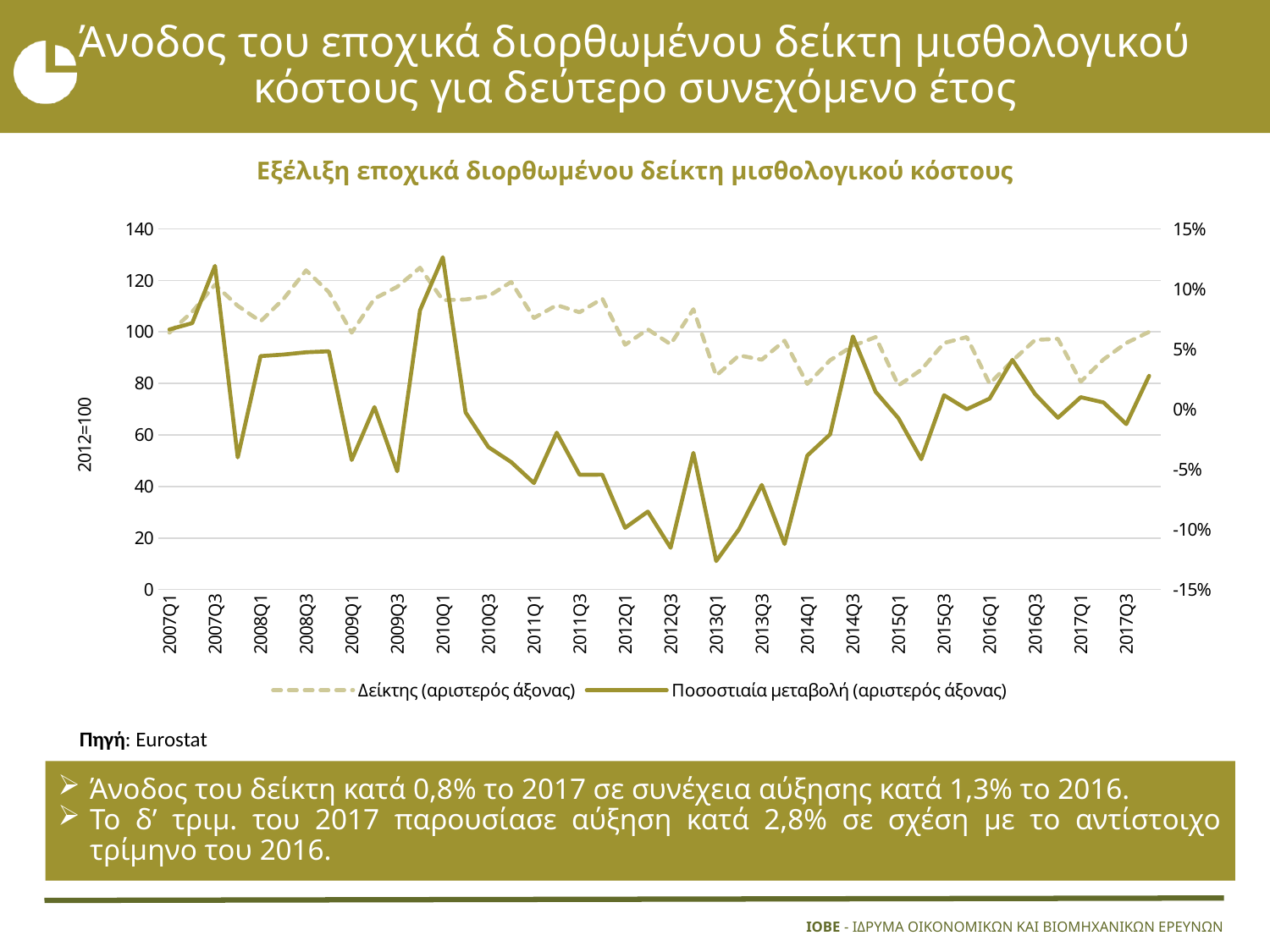
Which series is drawn with a dashed line? Δείκτης (αριστερός άξονας) How many quarter labels are shown on the x axis? 22 Is the value of the Δείκτης series at 2013Q1 greater or less than 100? less How many series does the legend list? 2 At which quarter does the Ποσοστιαία μεταβολή series reach its lowest point? 2013Q1 Is the value of the Ποσοστιαία μεταβολή series at 2010Q1 greater or less than 10%? greater What kind of chart is shown on the slide? Line chart What is the title of the chart? Εξέλιξη εποχικά διορθωμένου δείκτη μισθολογικού κόστους Does the Δείκτης series rise or fall between 2009Q3 and 2014Q1? fall Is the value of the Δείκτης series at 2008Q1 greater or less than 100? greater